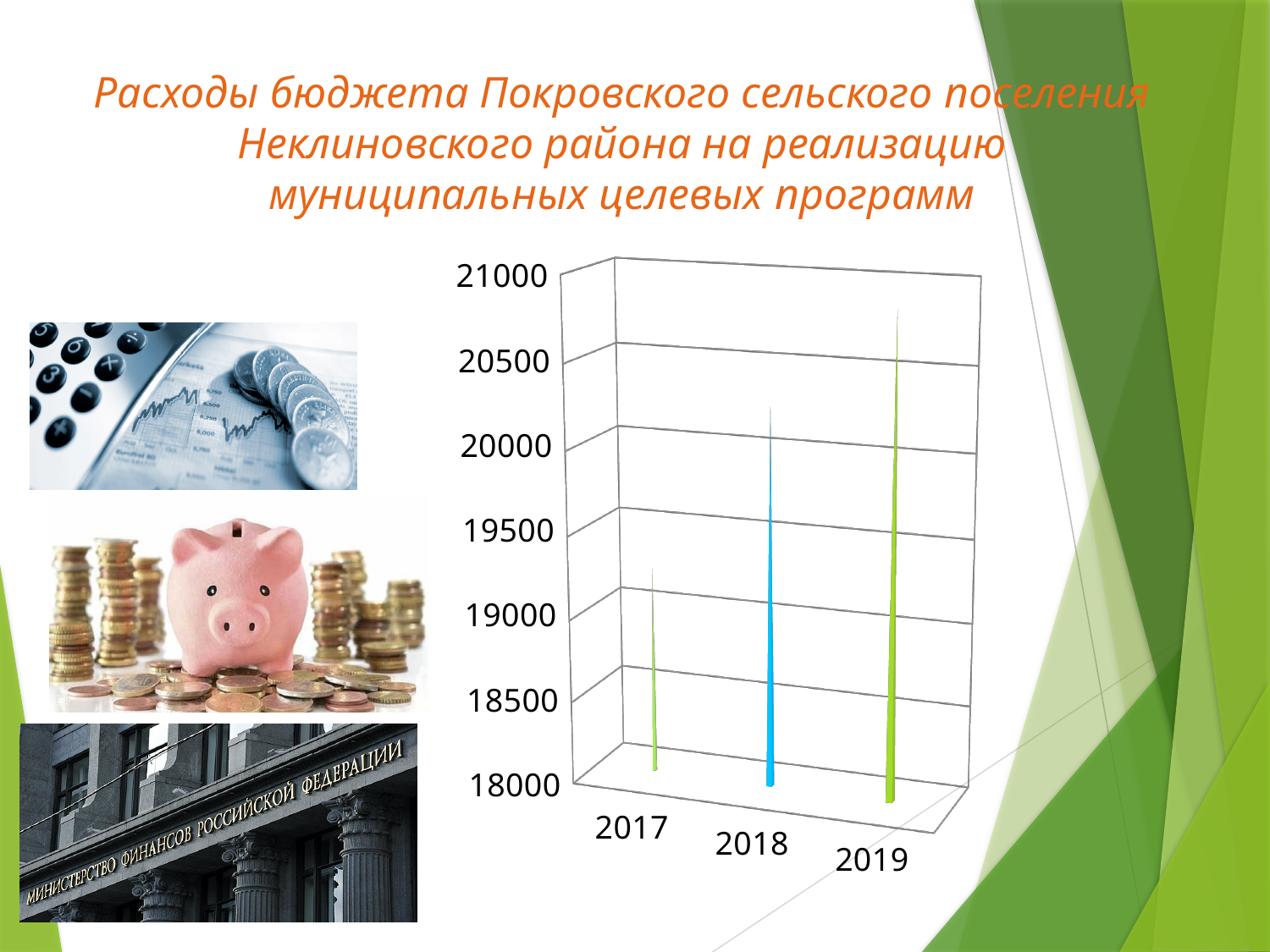
Is the value for 2019 greater or less than 20000? greater Which year has the highest value in the chart? 2019 Which is larger, the value for 2019 or the value for 2018? 2019 What is the highest value shown on the vertical axis of the chart? 21000 Do the values rise or fall from 2017 to 2019? rise How many years are shown on the x axis of the chart? 3 Which year has the lowest value in the chart? 2017 Which is larger, the value for 2018 or the value for 2017? 2018 What kind of chart is shown on the slide? bar chart Is the value for 2017 greater or less than 18500? greater Is the value for 2017 greater or less than 20000? less